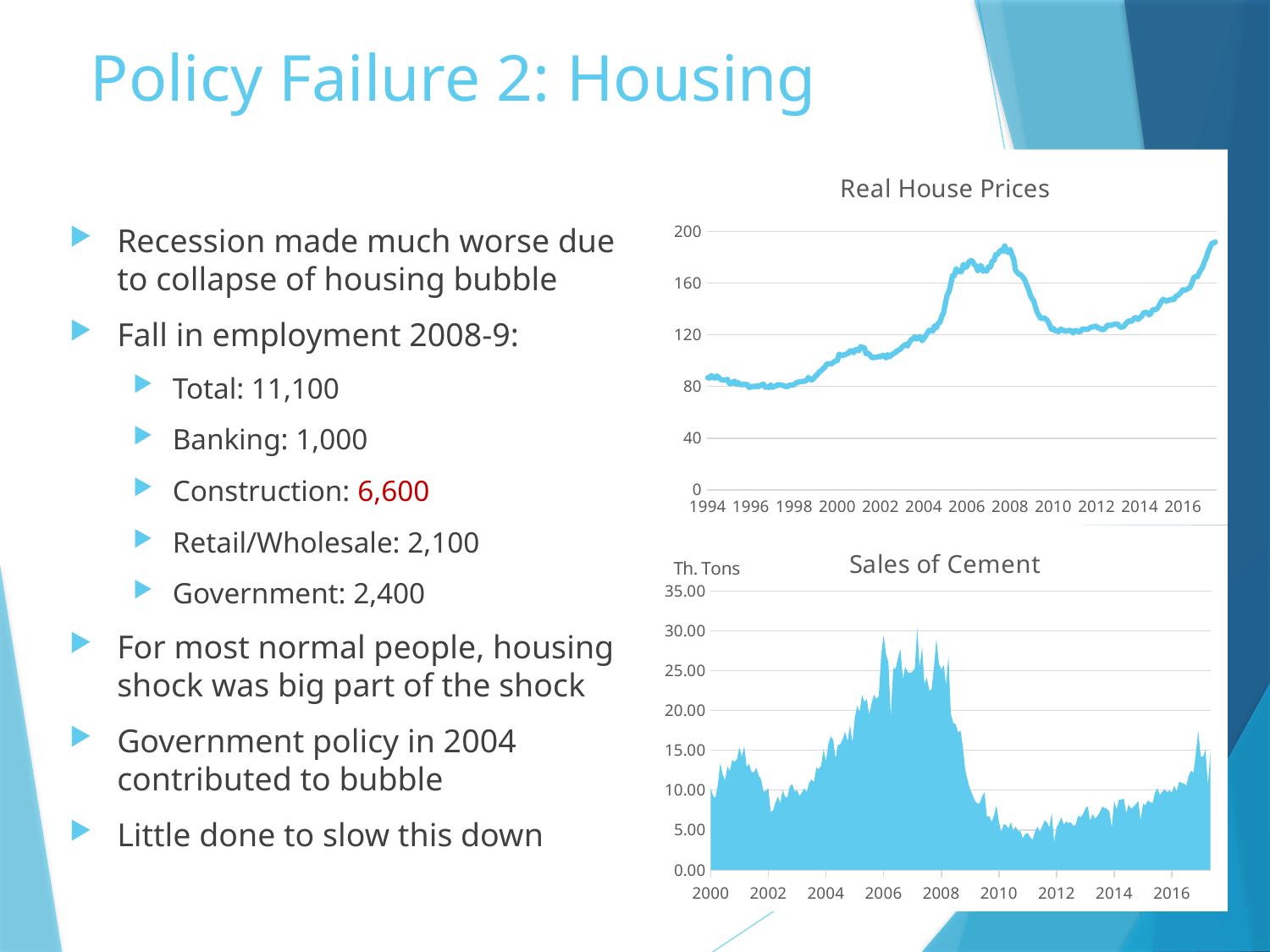
What kind of chart is the Sales of Cement chart? area chart In the Real House Prices chart, do values rise or fall between 2010 and 2016? rise In the Sales of Cement chart, do values rise or fall between 2008 and 2010? fall In the Real House Prices chart, is the value around 2008 greater or less than 160? greater In the Sales of Cement chart, is the value in 2004 greater or less than 10.00? greater In the Real House Prices chart, is the value in 1996 greater or less than 120? less What is the title of the top chart on the slide? Real House Prices What kind of chart is the Real House Prices chart? line chart What unit is shown on the y axis of the Sales of Cement chart? Th. Tons